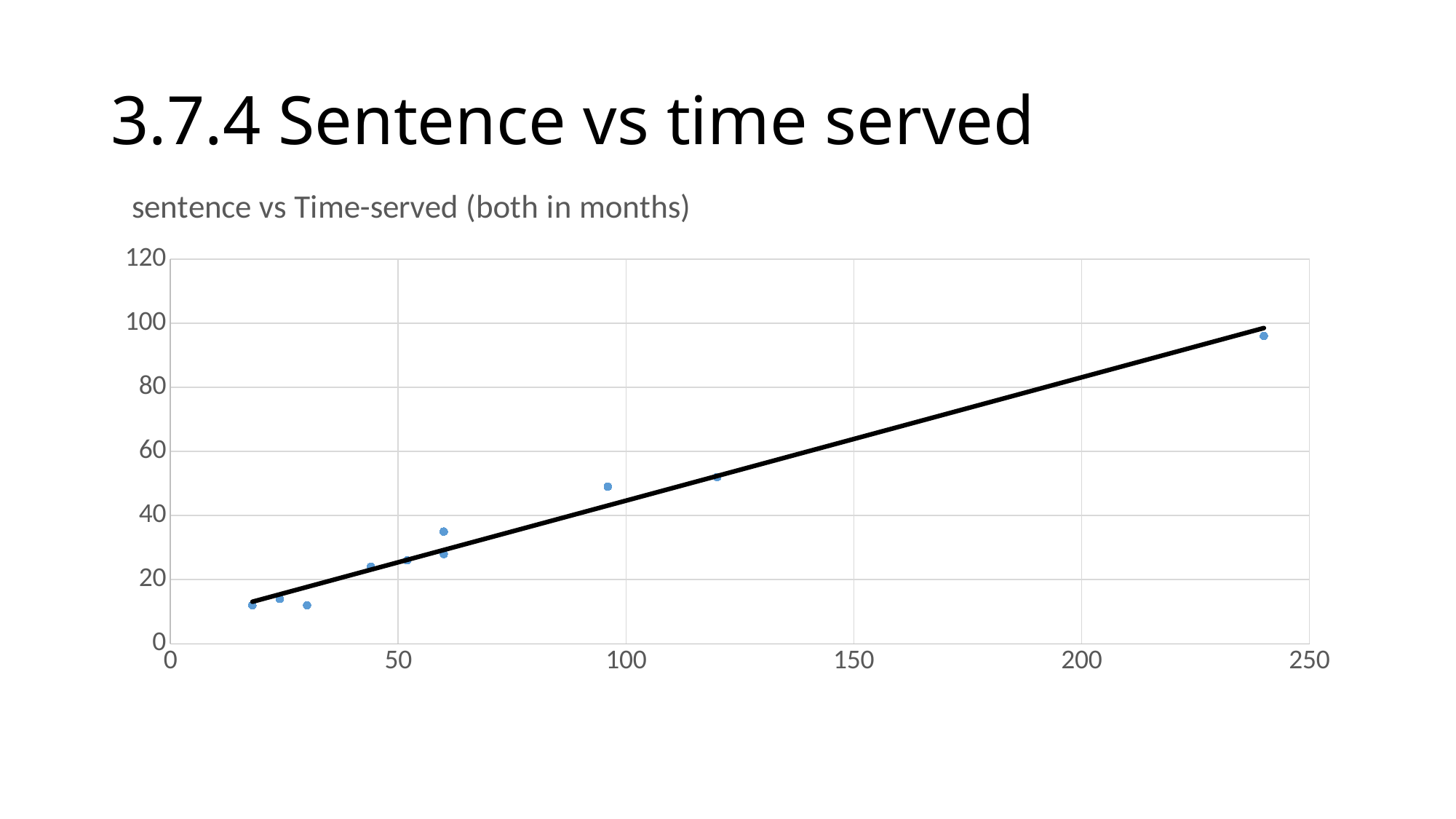
Which data point has the highest plotted value? the point near x = 240 What is the maximum value shown on the vertical axis? 120 Is the value of the rightmost data point (near x = 240) greater or less than 80? greater Do the plotted values rise or fall as the x-axis value increases? rise What is the title of the chart? sentence vs Time-served (both in months) Is the value of the data point near x = 120 greater or less than 60? less Are the values of the data points near x = 20 greater or less than 20? less What kind of chart is shown on the slide? scatter chart Which data point has the highest value: the one near x = 240 or the one near x = 120? the one near x = 240 How many data points are plotted on the chart? 10